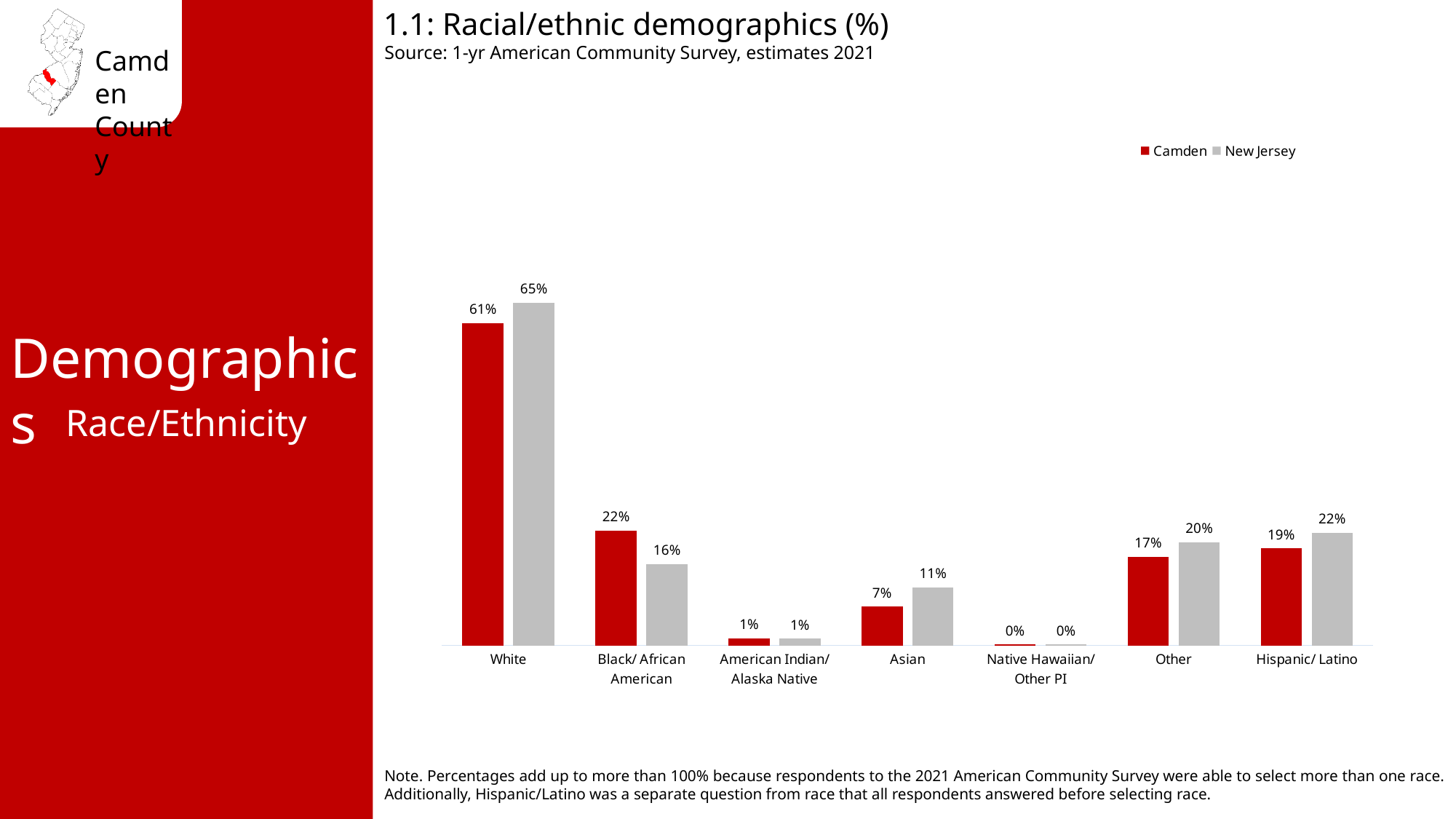
Which category has the lowest New Jersey value? Native Hawaiian/ Other PI What is the New Jersey value for Hispanic/ Latino? 22% Which is larger for Black/ African American, the Camden value or the New Jersey value? Camden How many series does the legend list? 2 What is the Camden value for Black/ African American? 22% What is the Camden value for White? 61% What kind of chart is shown on the slide? Bar chart Which category has the highest Camden value? White What is the difference between the New Jersey and Camden values for White? 4% What is the New Jersey value for Asian? 11% How many categories are shown on the x axis? 7 What is the title of the chart? 1.1: Racial/ethnic demographics (%)